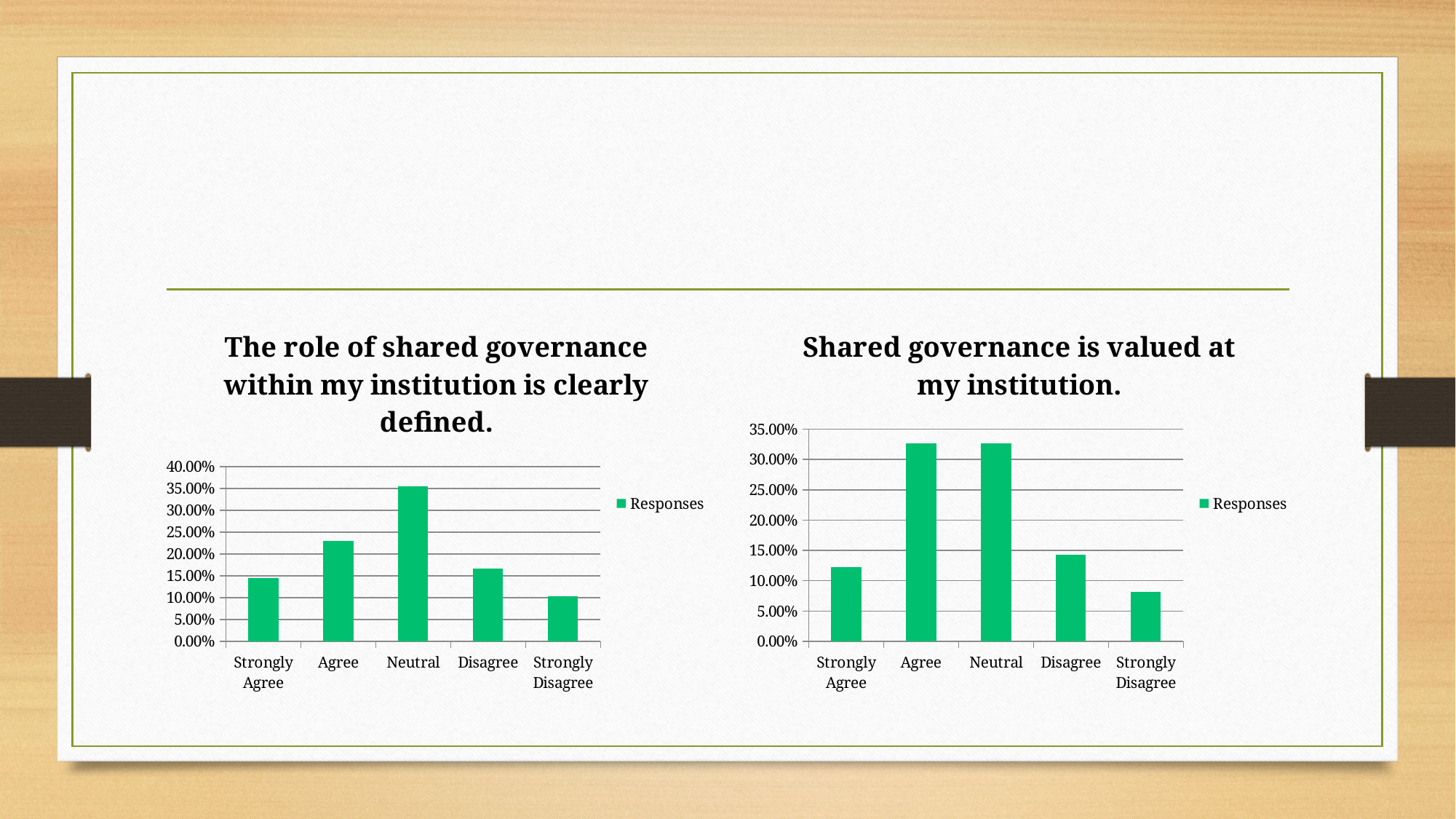
In the left chart, which is larger, the value for Agree or the value for Disagree? Agree In the left chart, is the value for Agree greater or less than 20.00%? greater In the chart titled "The role of shared governance within my institution is clearly defined.", which category has the highest value? Neutral In the chart titled "Shared governance is valued at my institution.", which category has the lowest value? Strongly Disagree In the right chart, which is larger, the value for Disagree or the value for Strongly Agree? Disagree What series name does the legend of the right chart list? Responses In the right chart, is the value for Strongly Disagree greater or less than 10.00%? less How many categories are shown on the x axis of the chart titled "Shared governance is valued at my institution."? 5 In the left chart, is the value for Neutral greater or less than 30.00%? greater In the chart titled "The role of shared governance within my institution is clearly defined.", which category has the lowest value? Strongly Disagree What kind of chart is the chart titled "The role of shared governance within my institution is clearly defined."? Bar chart